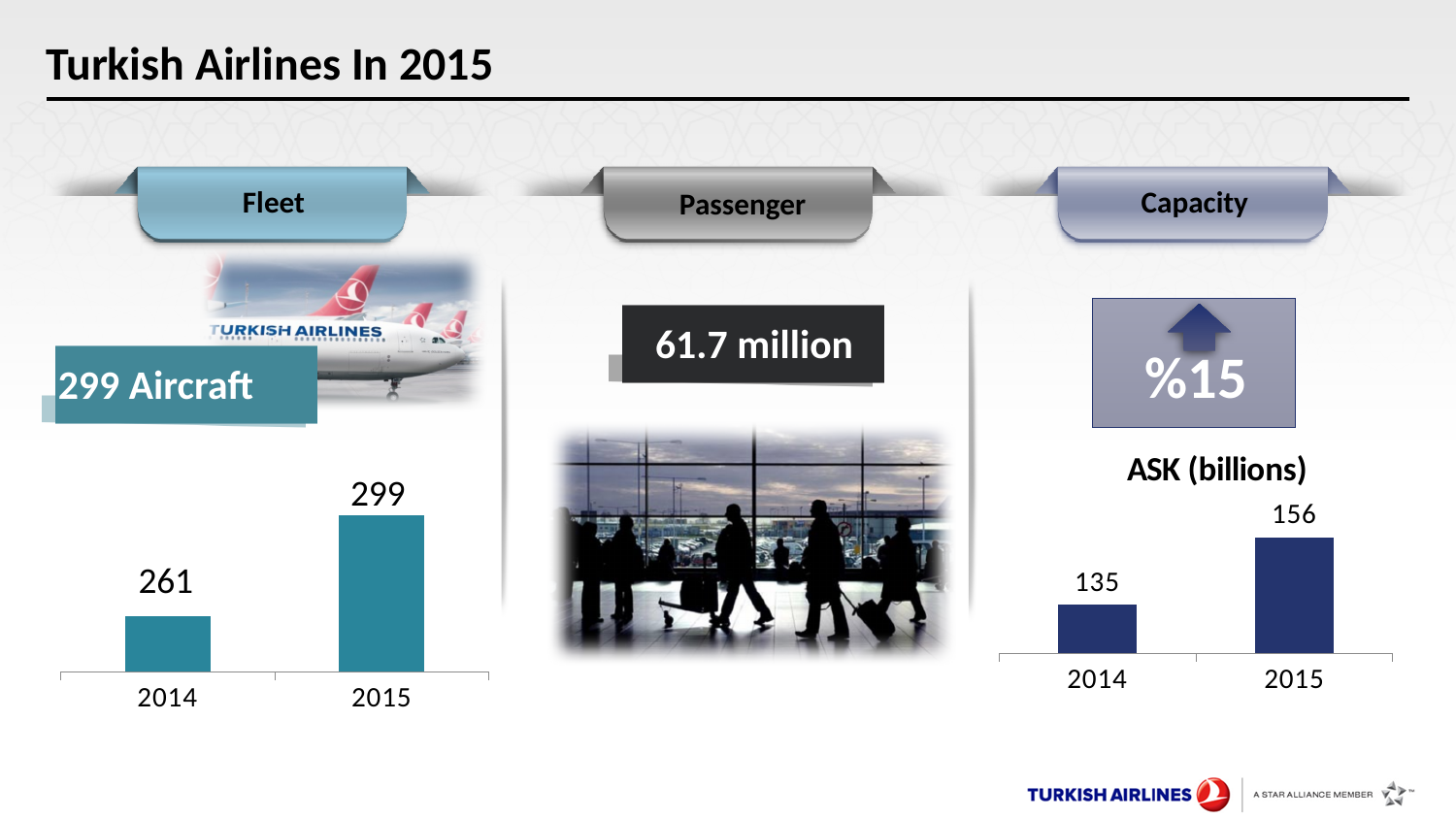
In the ASK (billions) chart on the right, do the values rise or fall from 2014 to 2015? Rise In the ASK (billions) chart on the right, what is the difference between 2015 and 2014? 21 In the Fleet chart on the left, which year has the higher value? 2015 In the Fleet chart on the left, what is the value for 2014? 261 What is the title of the bar chart on the right of the slide? ASK (billions) In the Fleet chart on the left, how many years are shown? 2 In the ASK (billions) chart on the right, what is the value for 2014? 135 In the ASK (billions) chart on the right, which year has the lower value? 2014 In the Fleet chart on the left, by how much did the value increase from 2014 to 2015? 38 What kind of chart is the Fleet chart on the left? Bar chart In the ASK (billions) chart on the right, what is the value for 2015? 156 In the Fleet chart on the left, what is the value for 2015? 299